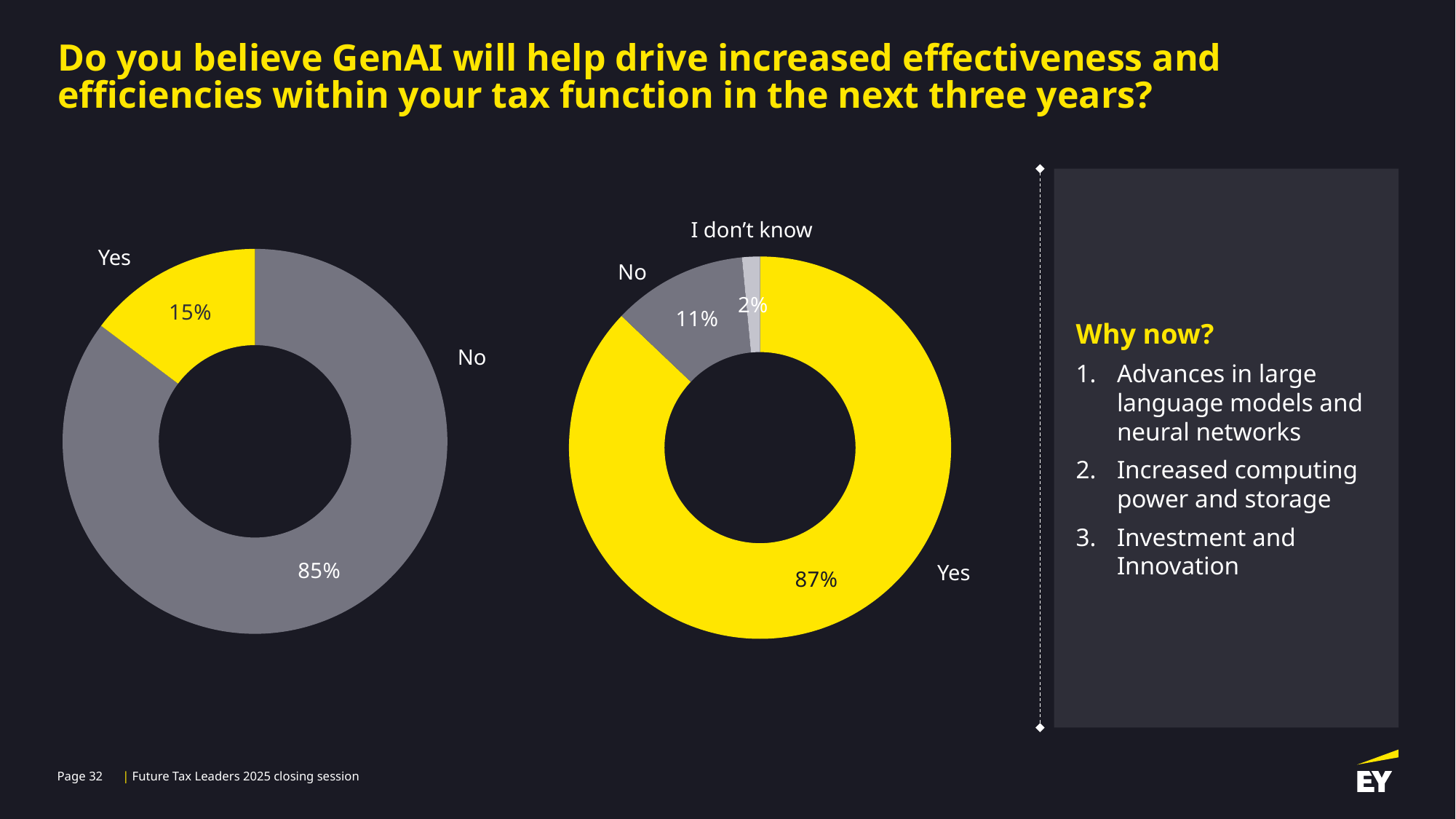
In the left doughnut chart, what is the difference between the No and Yes percentages? 70% In the left doughnut chart, which category has the largest share? No In the right doughnut chart, what percentage is shown for Yes? 87% What type of chart is used on the left of the slide? Doughnut chart In the right doughnut chart, which category has the largest share? Yes In the right doughnut chart, what is the difference between the Yes and No percentages? 76% In the right doughnut chart, which category has the smallest share? I don't know How many categories does the right doughnut chart show? 3 In the right doughnut chart, what percentage is shown for I don't know? 2% In the left doughnut chart, what percentage is shown for Yes? 15% In the right doughnut chart, what percentage is shown for No? 11% In the left doughnut chart, what percentage is shown for No? 85%